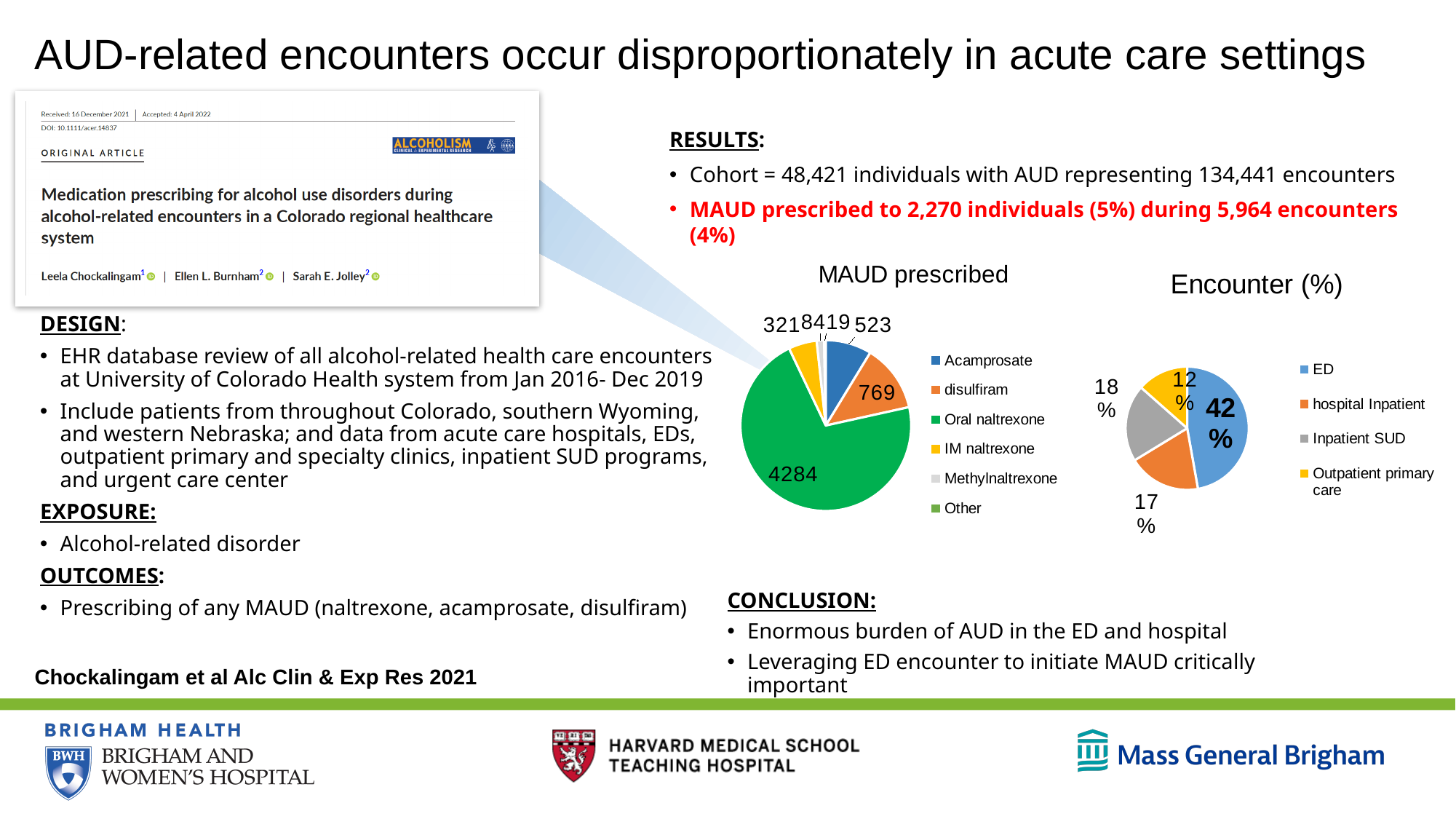
How many entries does the legend of the MAUD prescribed chart list? 6 How many categories does the Encounter (%) chart show? 4 In the Encounter (%) chart, what percentage is shown for Outpatient primary care? 12% In the MAUD prescribed chart, which medication has the largest slice? Oral naltrexone What type of chart is the Encounter (%) chart? Pie chart In the Encounter (%) chart, which setting has the smallest share? Outpatient primary care In the Encounter (%) chart, what percentage is shown for ED? 42% In the MAUD prescribed chart, what value is shown for disulfiram? 769 In the MAUD prescribed chart, what value is shown for Acamprosate? 523 In the MAUD prescribed chart, what value is shown for Oral naltrexone? 4284 In the MAUD prescribed chart, what is the difference between the disulfiram and Acamprosate values? 246 In the MAUD prescribed chart, which is larger, disulfiram or Acamprosate? disulfiram